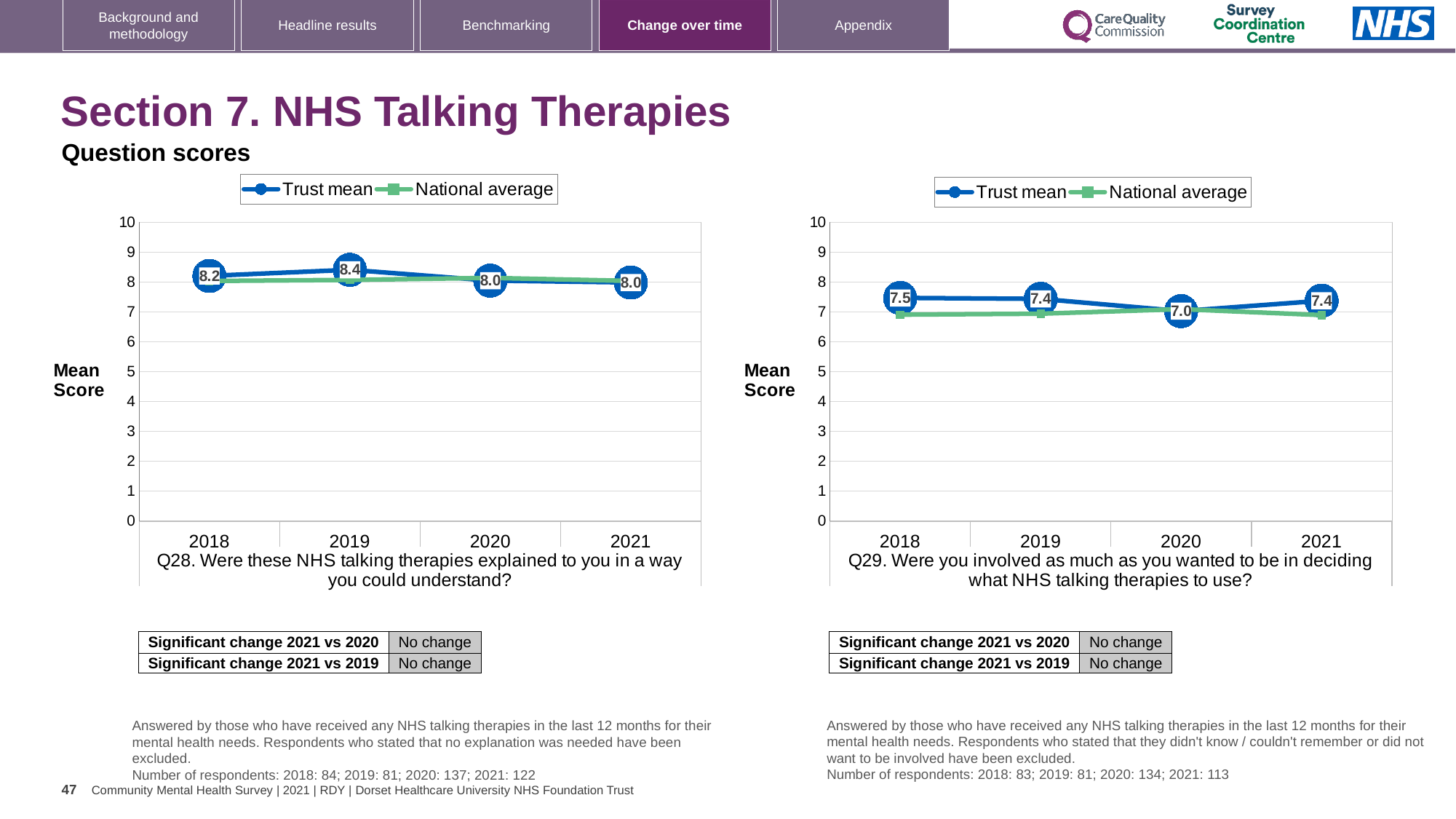
On the Q29 chart, what is the Trust mean score for 2020? 7.0 On the Q28 chart, what is the Trust mean score for 2019? 8.4 On the Q29 chart, is the Trust mean for 2020 greater or less than 8? less On the Q29 chart, in which year is the Trust mean lowest? 2020 On the Q28 chart, what is the difference between the Trust mean in 2019 and in 2021? 0.4 On the Q29 chart, what is the Trust mean score for 2018? 7.5 On the Q28 chart, in which year is the Trust mean highest? 2019 On the Q28 chart, what is the Trust mean score for 2021? 8.0 On the Q29 chart, what is the difference between the Trust mean in 2018 and in 2020? 0.5 On the Q28 chart, which year has the larger Trust mean, 2018 or 2019? 2019 How many series does the legend of the Q28 chart list? 2 How many years are plotted on the Q29 chart? 4